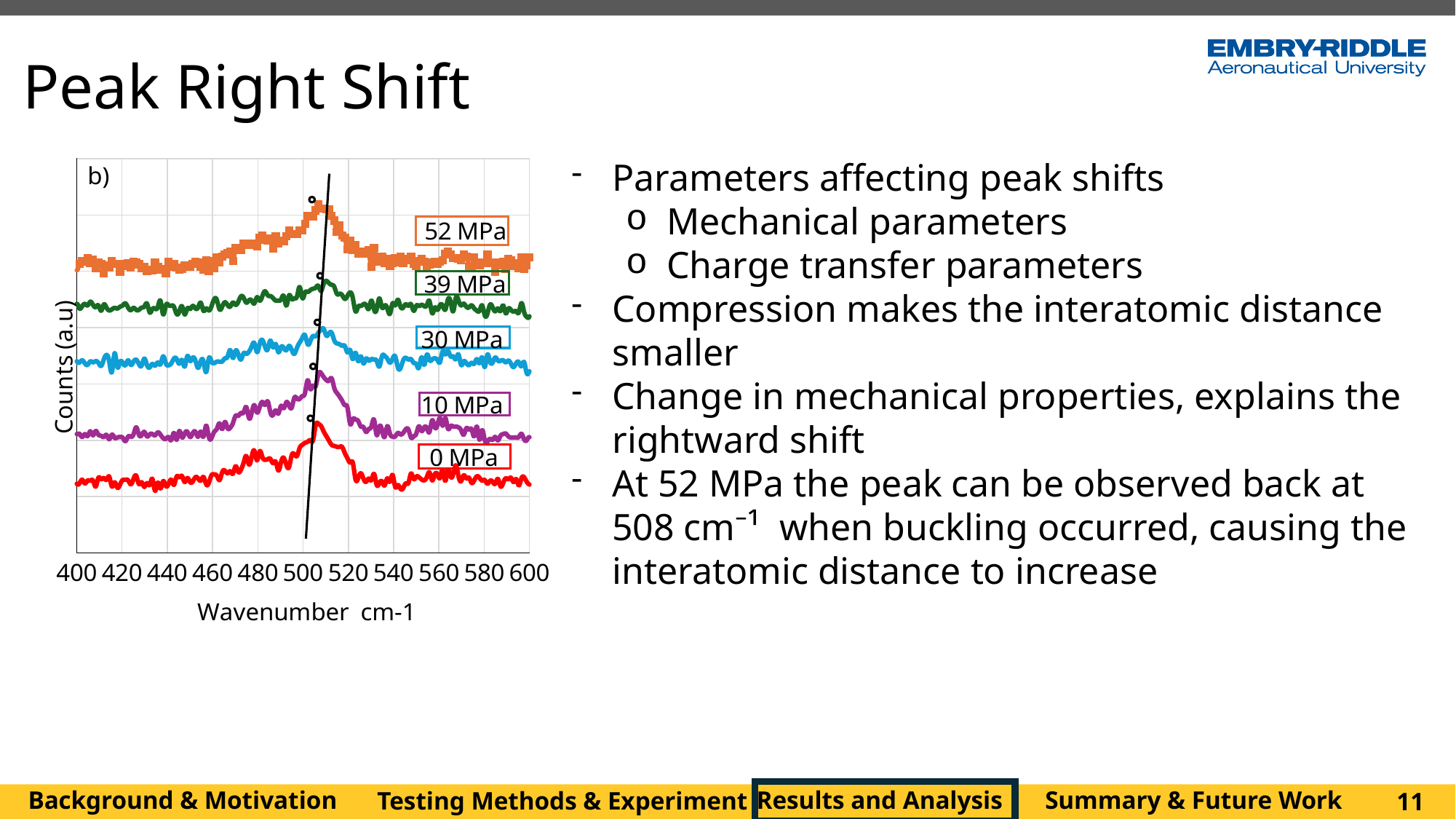
What colour is the 0 MPa curve on the chart? red Which pressure series is plotted at the top of the chart? 52 MPa How many tick labels are shown on the x axis of the chart? 11 How many pressure series are plotted on the chart? 5 Is the peak of the 30 MPa curve located at a wavenumber greater or less than 460? greater What is the label of the x axis of the chart? Wavenumber cm-1 What kind of chart is shown on the slide? line chart Is the peak of the 0 MPa curve located at a wavenumber greater or less than 480? greater Which pressure series is plotted at the bottom of the chart? 0 MPa Is the peak of the 52 MPa curve located at a wavenumber greater or less than 540? less Which curve is drawn higher on the chart, the 39 MPa curve or the 10 MPa curve? 39 MPa